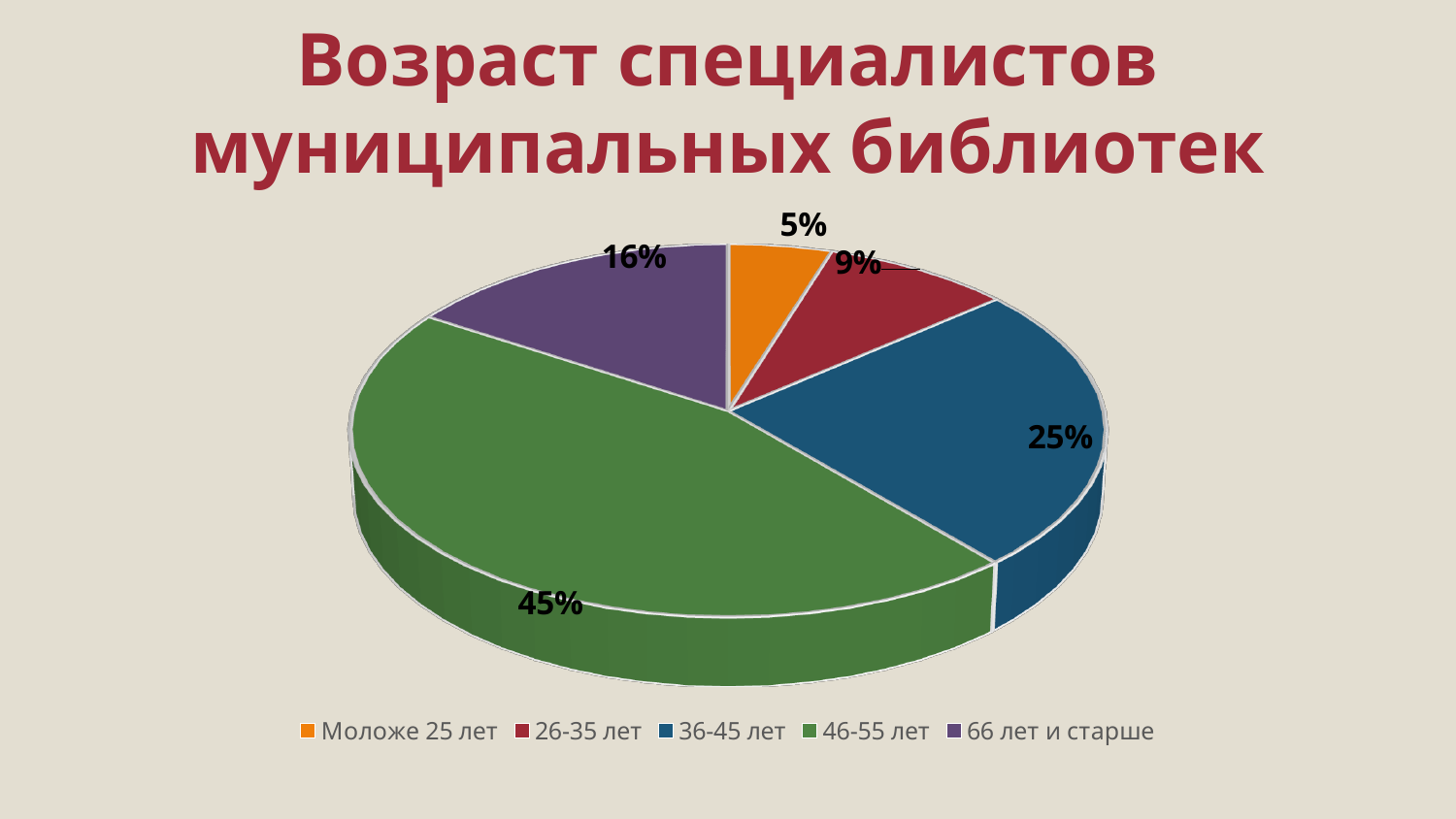
Which is larger, the share for 66 лет и старше or the share for 26-35 лет? 66 лет и старше What is the difference between the shares for 46-55 лет and 36-45 лет? 20% Which age category has the smallest share? Моложе 25 лет What share of the pie does the 46-55 лет category have? 45% What is the value shown for 66 лет и старше? 16% Which age category has the largest share? 46-55 лет What is the title of the chart? Возраст специалистов муниципальных библиотек How many categories does the pie chart show? 5 What is the value shown for 36-45 лет? 25% What is the value shown for Моложе 25 лет? 5% What kind of chart is shown on the slide? Pie chart What is the value shown for 26-35 лет? 9%